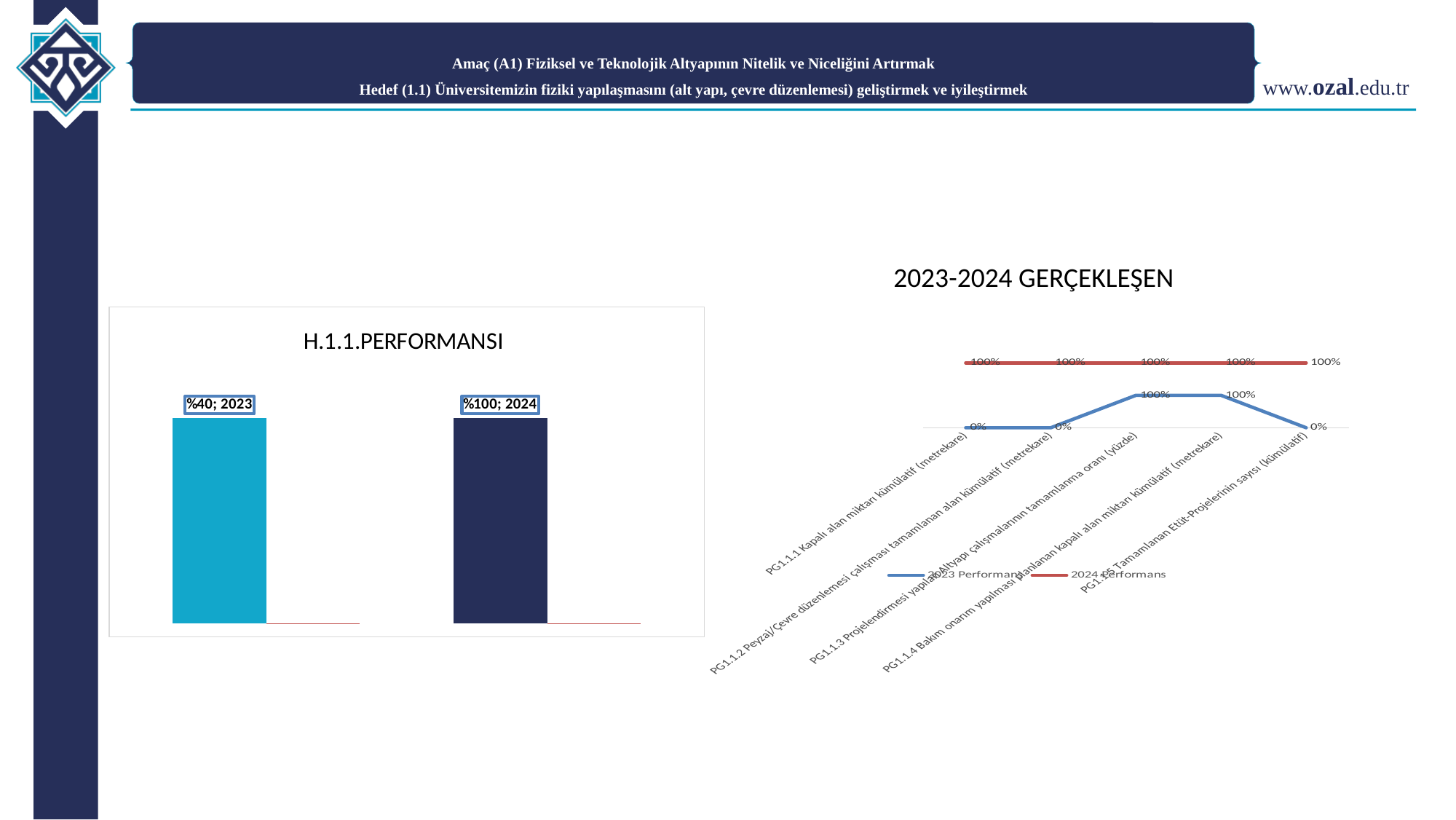
What kind of chart is the 2023-2024 GERÇEKLEŞEN chart? Line chart What kind of chart is the H.1.1.PERFORMANSI chart? Bar chart In the 2023-2024 GERÇEKLEŞEN chart, how many categories are plotted along the x axis? 5 How many bars are shown in the H.1.1.PERFORMANSI chart? 2 How many series does the legend of the 2023-2024 GERÇEKLEŞEN chart list? 2 In the H.1.1.PERFORMANSI chart, what is the value for 2024? %100 In the 2023-2024 GERÇEKLEŞEN chart, what is the 2024 Performans value for PG1.1.1? 100% In the H.1.1.PERFORMANSI chart, what is the value for 2023? %40 In the H.1.1.PERFORMANSI chart, which year has the higher value? 2024 In the 2023-2024 GERÇEKLEŞEN chart, what is the 2023 Performans value for PG1.1.3? 100% In the 2023-2024 GERÇEKLEŞEN chart, what is the 2023 Performans value for PG1.1.5? 0% In the H.1.1.PERFORMANSI chart, what is the difference between the 2024 and 2023 values? 60 percentage points